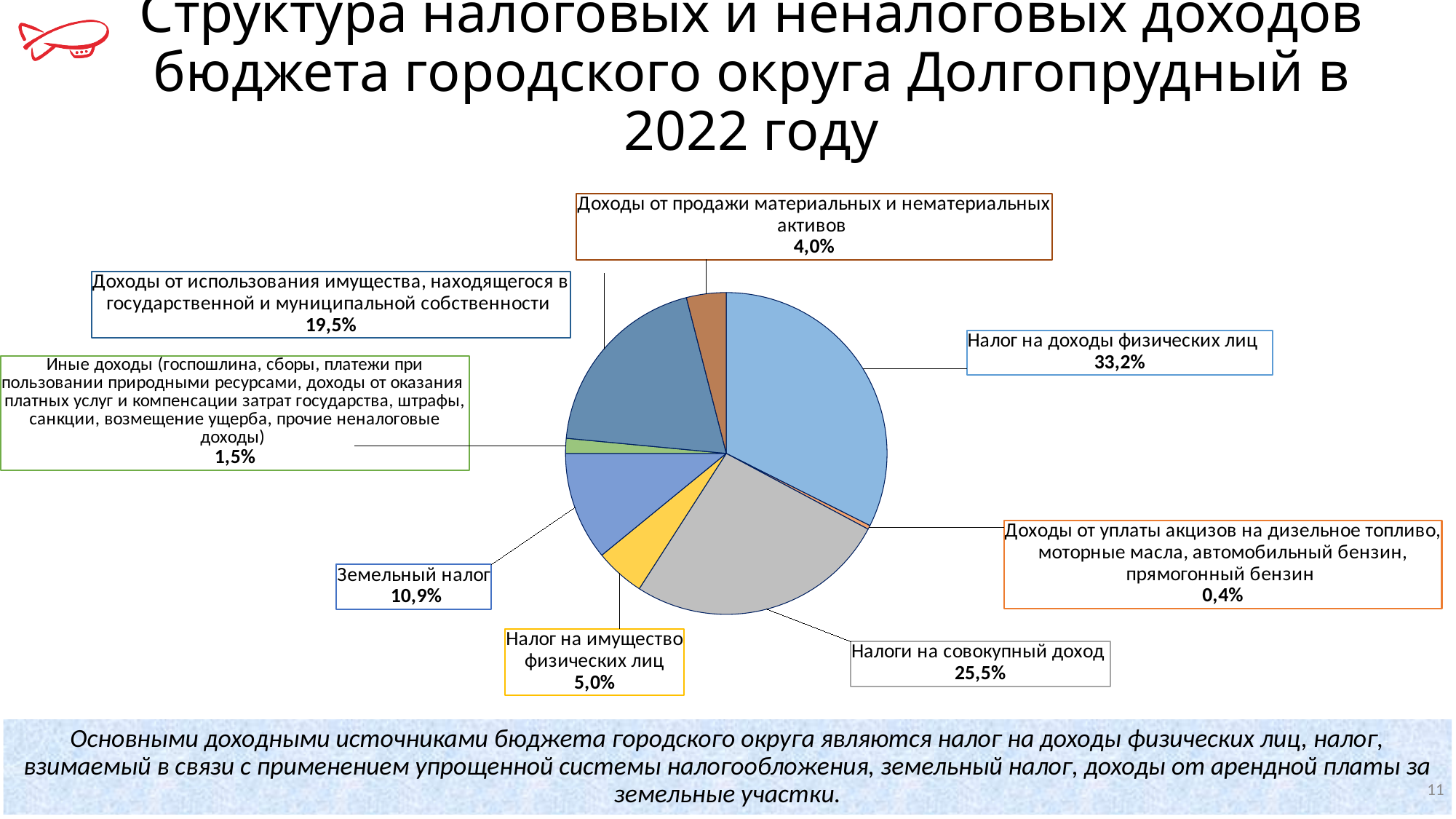
Какова доля налогов на совокупный доход? 25,5% Какова суммарная доля земельного налога и налога на имущество физических лиц? 15,9% Какова доля доходов от использования имущества, находящегося в государственной и муниципальной собственности? 19,5% Сколько категорий (секторов) показано на круговой диаграмме? 8 Какой тип диаграммы показан на слайде? Круговая диаграмма Какова доля налога на доходы физических лиц в структуре доходов бюджета? 33,2% На сколько процентных пунктов доля налога на доходы физических лиц больше доли налогов на совокупный доход? 7,7 Какой источник доходов имеет наименьшую долю? Доходы от уплаты акцизов на дизельное топливо, моторные масла, автомобильный бензин, прямогонный бензин Какова доля земельного налога? 10,9% Что больше: доля земельного налога или доля налога на имущество физических лиц? Земельный налог Какова доля доходов от уплаты акцизов на дизельное топливо, моторные масла, автомобильный бензин, прямогонный бензин? 0,4% Какой источник доходов имеет наибольшую долю в структуре доходов бюджета? Налог на доходы физических лиц